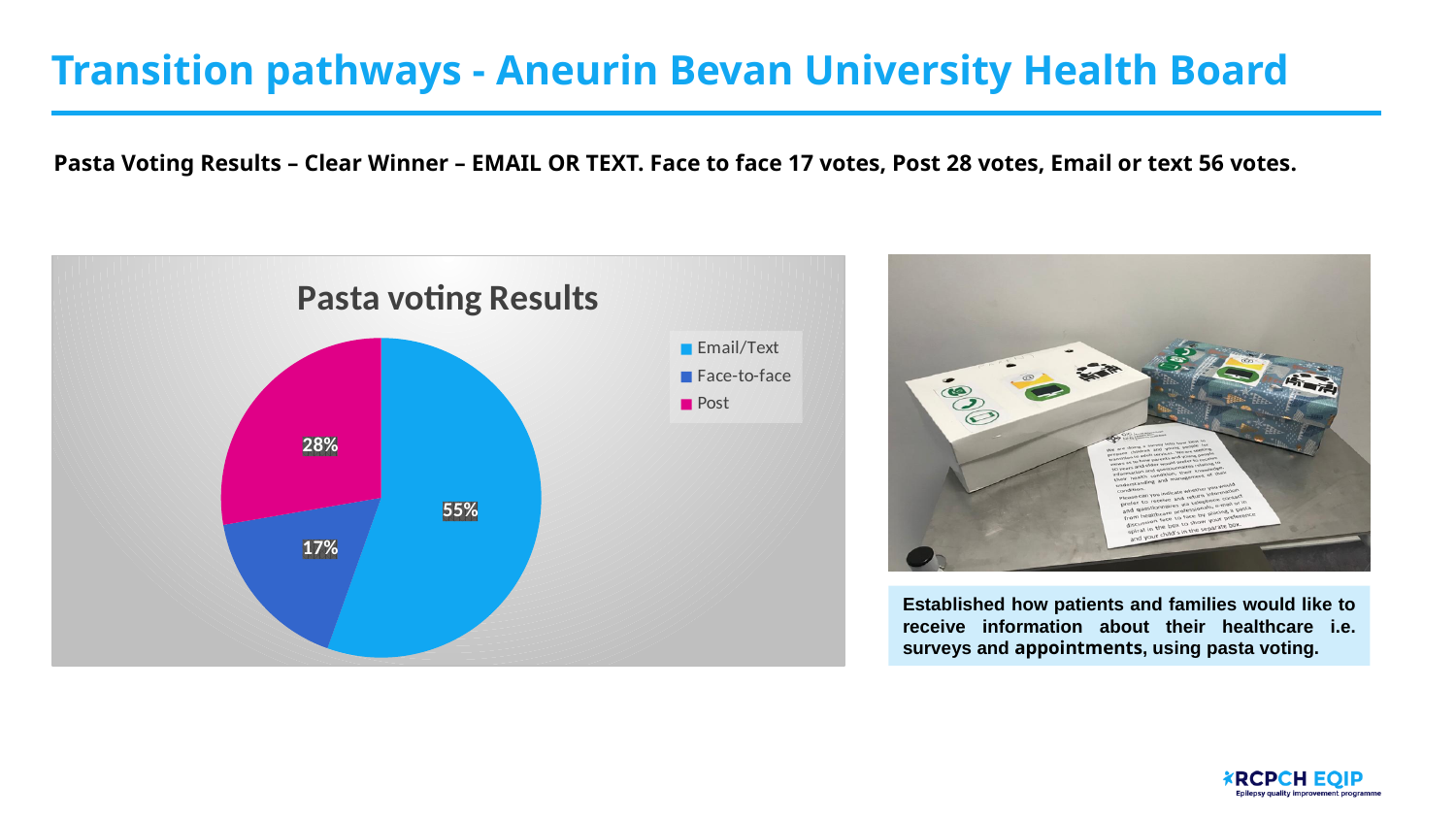
What percentage of the pie does Face-to-face represent? 17% Which category has the smallest share of the pie? Face-to-face Which category has the largest share of the pie? Email/Text What colour is the Post slice in the pie chart? Magenta/pink What is the title of the chart? Pasta voting Results How many slices does the pie chart have? 3 What kind of chart is shown on the slide? Pie chart What percentage of the pie does Email/Text represent? 55% How many categories does the legend list? 3 Which slice is larger, Post or Face-to-face? Post What is the difference in percentage points between the Email/Text and Post slices? 27 What percentage of the pie does Post represent? 28%